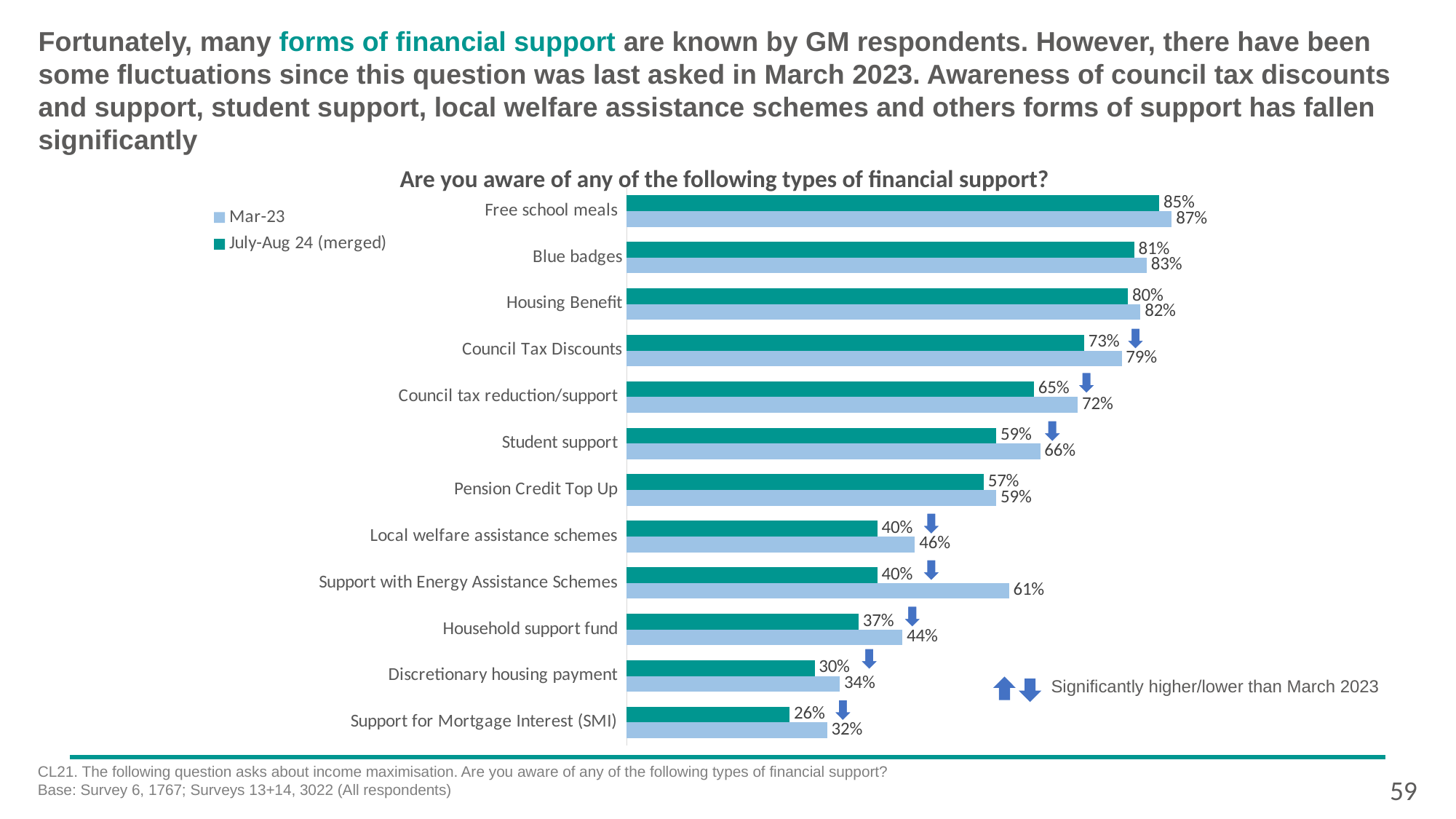
What was the July-Aug 24 (merged) awareness value for Discretionary housing payment? 30% Which type of financial support had the highest awareness in Mar-23? Free school meals What percentage of respondents were aware of Free school meals in July-Aug 24 (merged)? 85% What kind of chart is shown on the slide? Bar chart What was the Mar-23 awareness value for Support with Energy Assistance Schemes? 61% By how many percentage points did awareness of Support with Energy Assistance Schemes fall from Mar-23 to July-Aug 24 (merged)? 21 percentage points How many types of financial support are listed in the chart? 12 Which type of financial support had the lowest awareness in July-Aug 24 (merged)? Support for Mortgage Interest (SMI) Which is larger: the July-Aug 24 (merged) value for Student support or the July-Aug 24 (merged) value for Pension Credit Top Up? Student support What is the title of the chart? Are you aware of any of the following types of financial support? What is the difference between the Mar-23 and July-Aug 24 (merged) values for Council Tax Discounts? 6 percentage points How many series does the legend list? 2